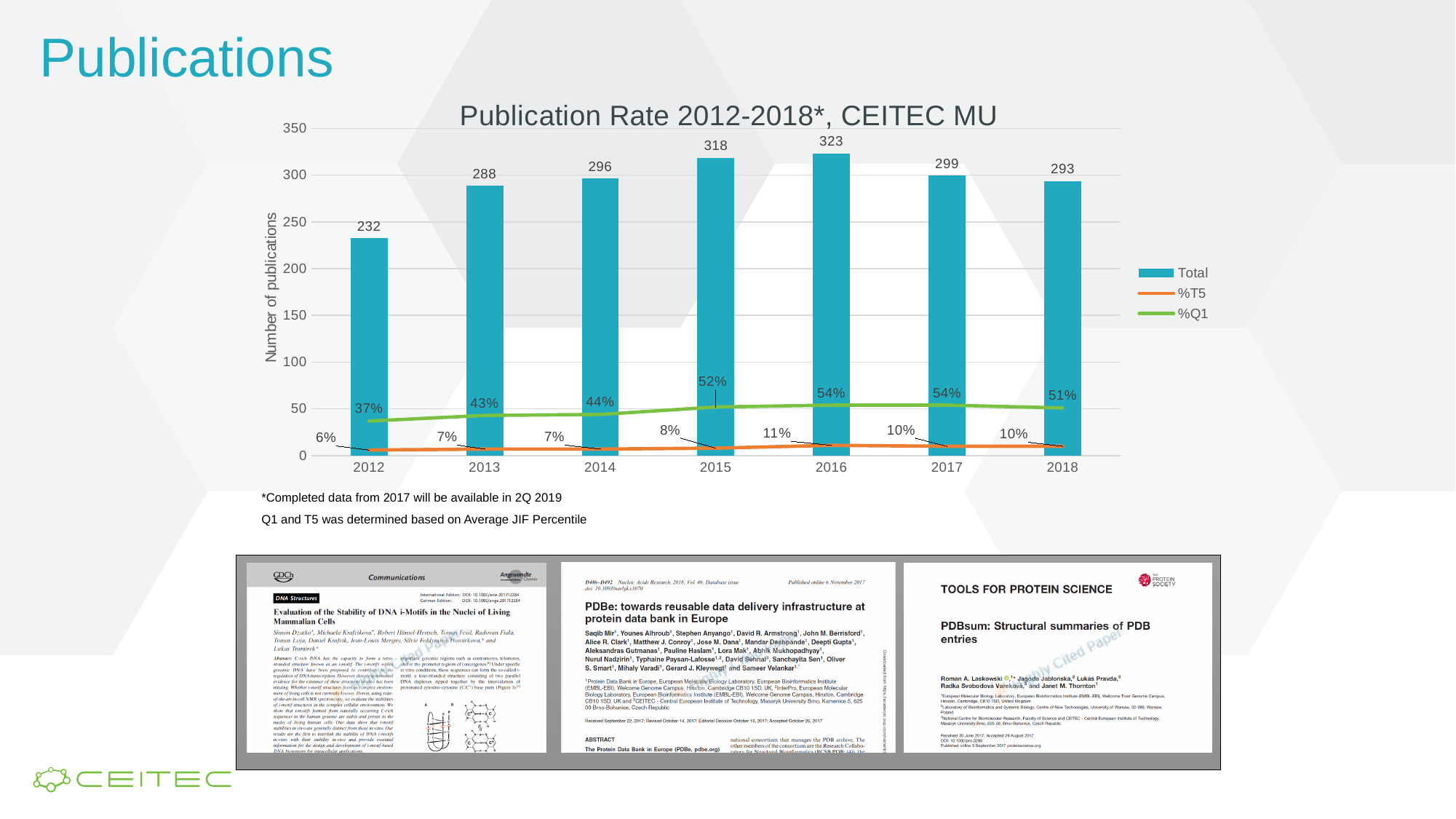
What is the %Q1 value for 2015? 52% Is the Total number of publications for 2013 greater or less than 250? greater Which year has the lowest Total number of publications? 2012 What is the Total number of publications for 2016? 323 How many series does the legend list? 3 How many years are shown on the x axis of the chart? 7 What is the label of the y axis? Number of publications Which year has the highest Total number of publications? 2016 Which year has a higher Total number of publications, 2015 or 2017? 2015 What is the %T5 value for 2012? 6% What is the difference between the Total publications in 2016 and 2012? 91 What is the title of the chart? Publication Rate 2012-2018*, CEITEC MU